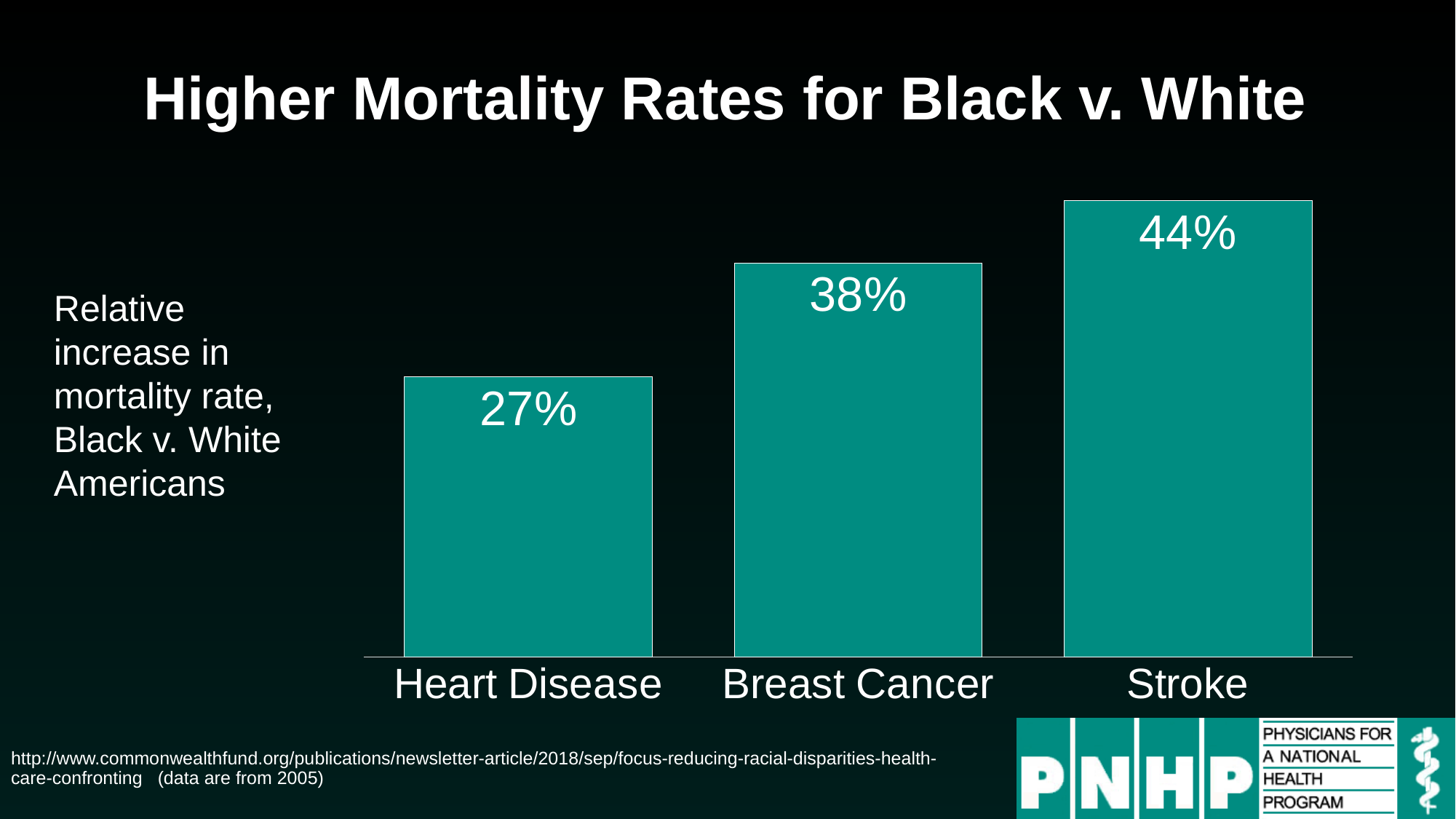
Which category has the highest relative increase in mortality rate? Stroke What is the title of the slide containing the chart? Higher Mortality Rates for Black v. White What kind of chart is shown on the slide? Bar chart Do the values rise or fall from Heart Disease to Stroke along the x axis? Rise How many categories are shown in the chart? 3 What is the relative increase in mortality rate for Heart Disease? 27% What is the relative increase in mortality rate for Stroke? 44% What is the relative increase in mortality rate for Breast Cancer? 38% What is the difference between the values for Breast Cancer and Heart Disease? 11% What is the difference between the values for Stroke and Heart Disease? 17% Which is larger, the value for Breast Cancer or the value for Stroke? Stroke Which category has the lowest relative increase in mortality rate? Heart Disease